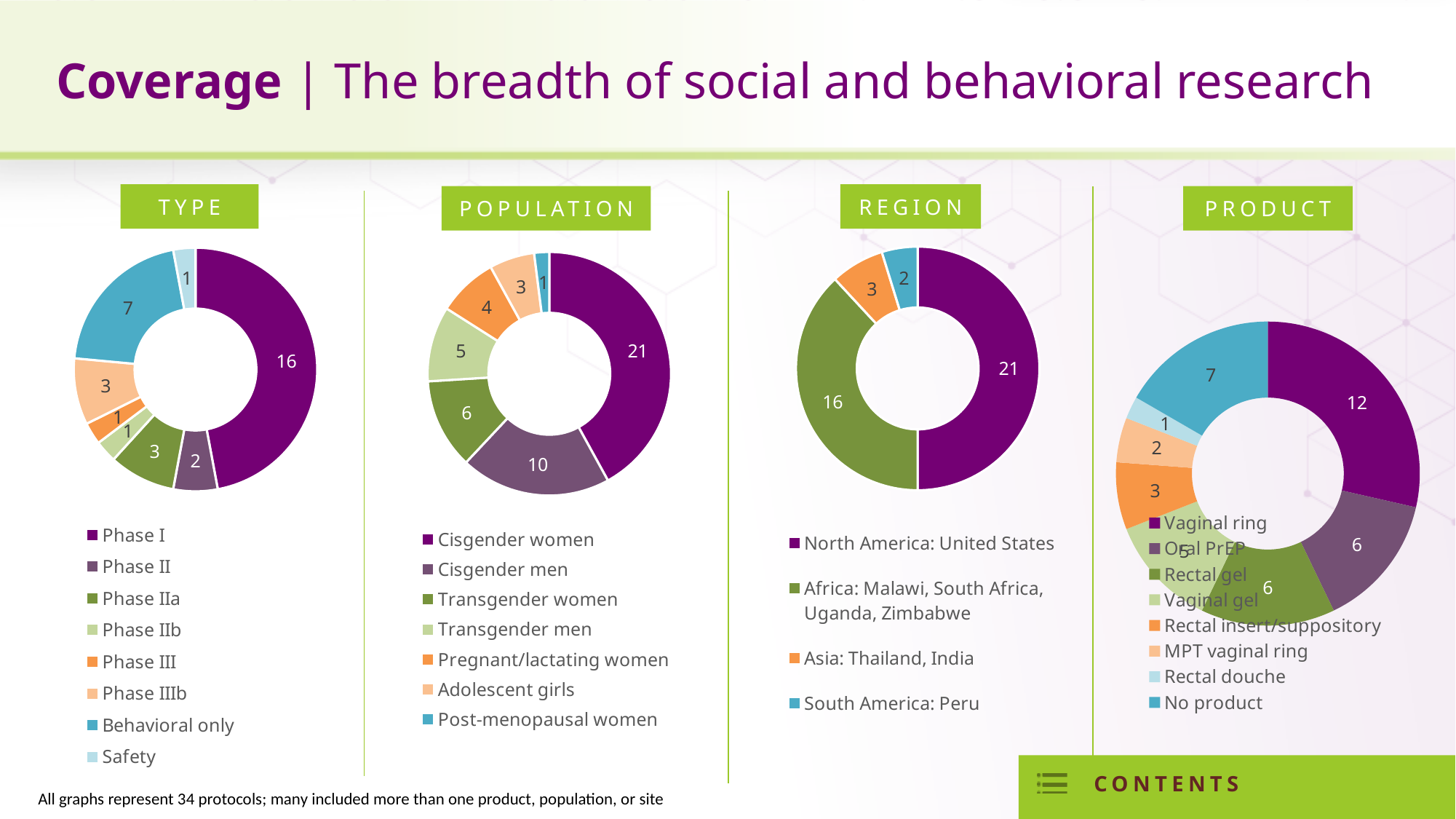
In the TYPE chart, which category has the largest value? Phase I How many categories does the REGION chart's legend list? 4 In the POPULATION chart, what is the value for Cisgender men? 10 In the REGION chart, which is larger: Asia: Thailand, India or South America: Peru? Asia: Thailand, India In the TYPE chart, how many protocols are Phase I? 16 What kind of chart is used for the TYPE data? Doughnut chart In the PRODUCT chart, what is the value for No product? 7 In the PRODUCT chart, what is the value for Vaginal ring? 12 In the POPULATION chart, what is the difference between Cisgender women and Cisgender men? 11 In the TYPE chart, what is the value for Behavioral only? 7 In the REGION chart, what is the value for Africa: Malawi, South Africa, Uganda, Zimbabwe? 16 In the POPULATION chart, which category has the smallest value? Post-menopausal women